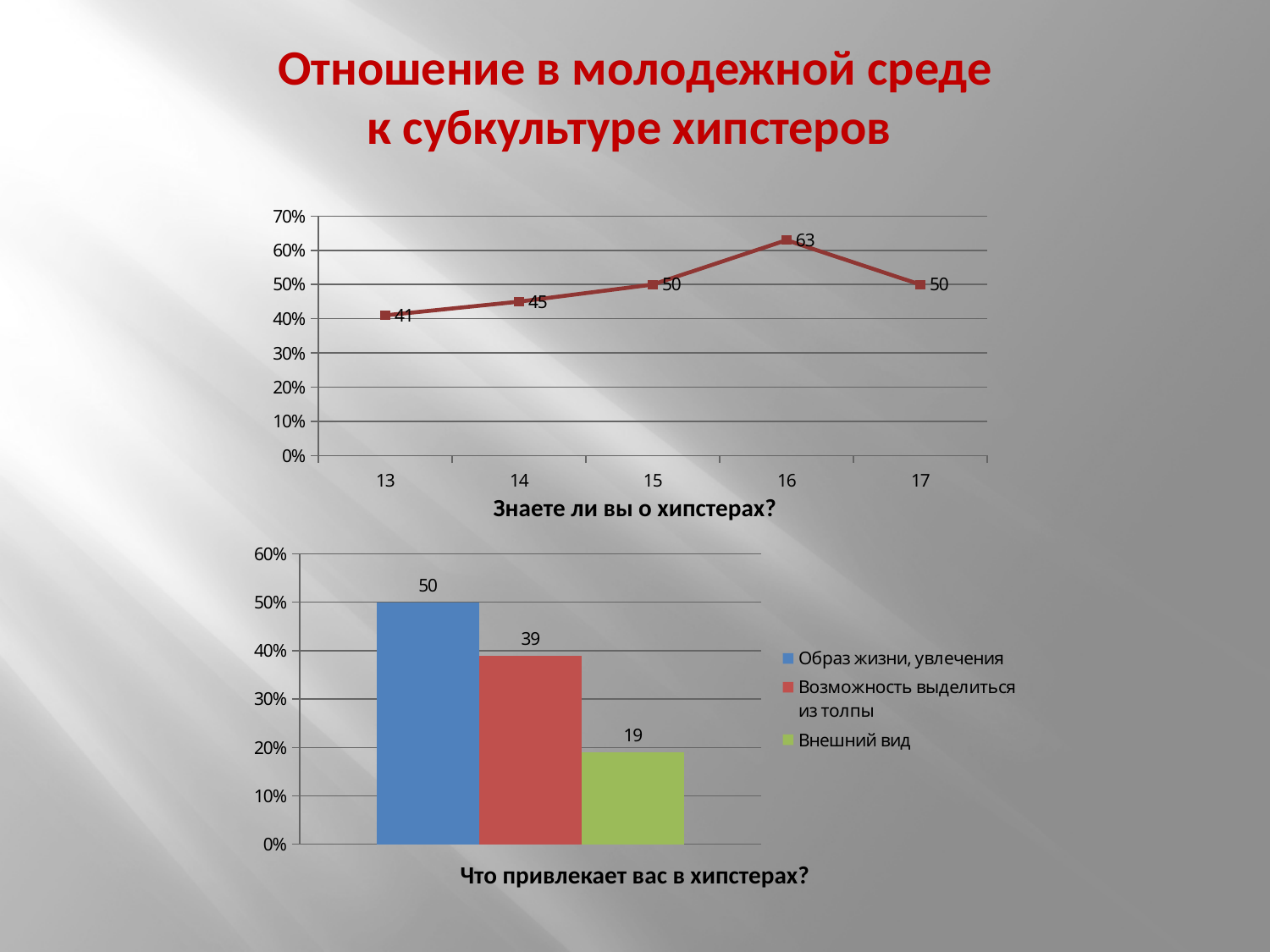
In the chart 'Знаете ли вы о хипстерах?', what is the value for age 16? 63 In the chart 'Что привлекает вас в хипстерах?', what is the value for 'Возможность выделиться из толпы'? 39 In the chart 'Знаете ли вы о хипстерах?', what is the value for age 13? 41 In the chart 'Что привлекает вас в хипстерах?', what is the difference between 'Образ жизни, увлечения' and 'Внешний вид'? 31 What kind of chart is 'Знаете ли вы о хипстерах?'? line chart In the chart 'Знаете ли вы о хипстерах?', which age has the highest value? 16 In the chart 'Знаете ли вы о хипстерах?', how many data points are plotted? 5 In the chart 'Знаете ли вы о хипстерах?', do the values rise or fall from age 13 to age 16? rise How many series does the legend of the chart 'Что привлекает вас в хипстерах?' list? 3 In the chart 'Знаете ли вы о хипстерах?', which age has the lowest value? 13 In the chart 'Что привлекает вас в хипстерах?', which category has the lowest value? Внешний вид In the chart 'Знаете ли вы о хипстерах?', what is the difference between the values for age 16 and age 14? 18